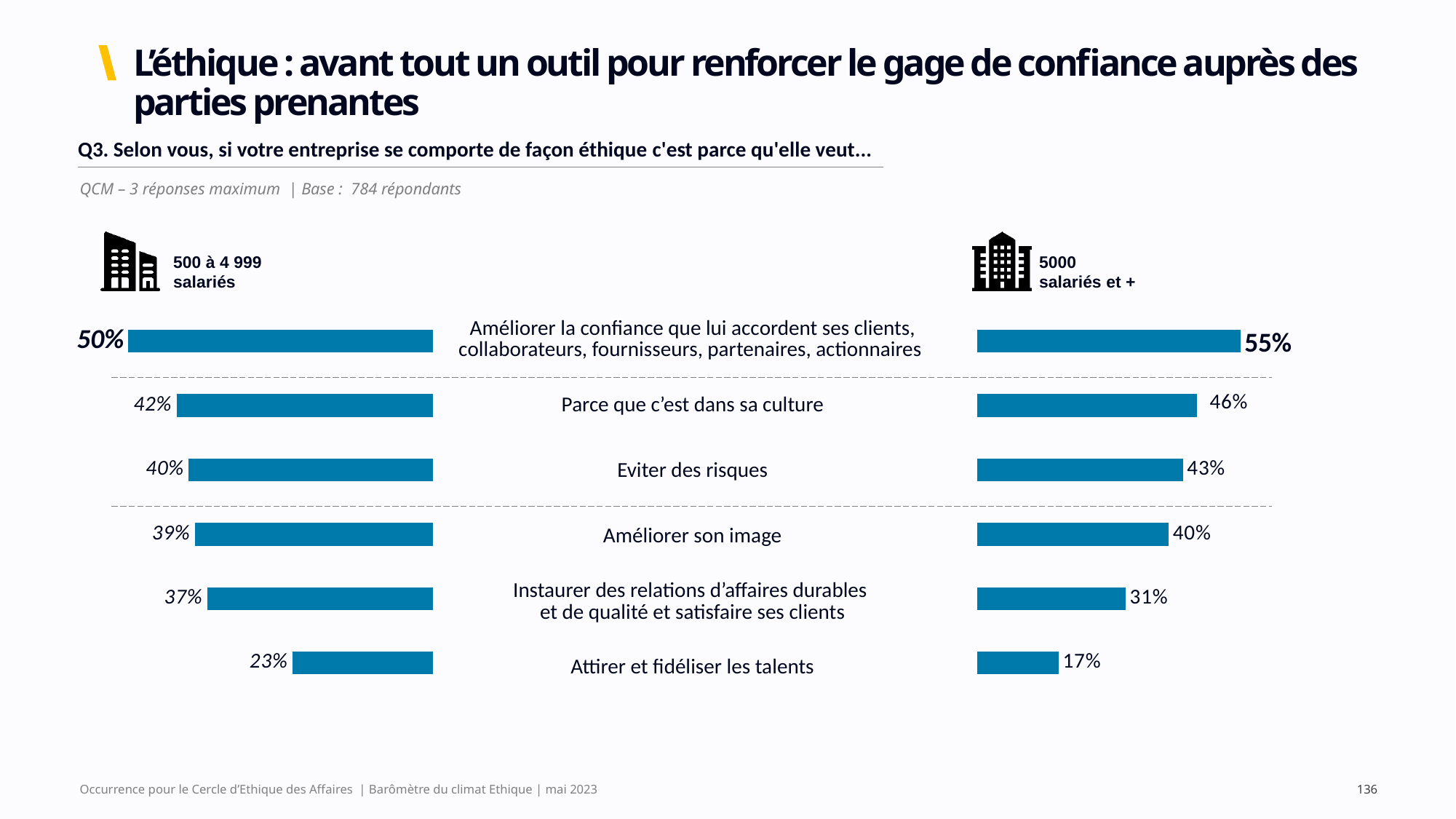
In the left chart (500 à 4 999 salariés), what is the value for "Parce que c'est dans sa culture"? 42% In the right chart (5000 salariés et +), what is the value for "Attirer et fidéliser les talents"? 17% What is the difference between the right chart (5000 salariés et +) and the left chart (500 à 4 999 salariés) for "Améliorer la confiance que lui accordent ses clients, collaborateurs, fournisseurs, partenaires, actionnaires"? 5 percentage points In the left chart (500 à 4 999 salariés), which category has the highest value? Améliorer la confiance que lui accordent ses clients, collaborateurs, fournisseurs, partenaires, actionnaires What is the base (number of respondents) stated for this question? 784 répondants For "Instaurer des relations d'affaires durables et de qualité et satisfaire ses clients", which group has the larger value: 500 à 4 999 salariés or 5000 salariés et +? 500 à 4 999 salariés In the right chart (5000 salariés et +), what is the value for "Améliorer son image"? 40% How many categories are shown in each chart? 6 In the right chart (5000 salariés et +), what is the value for "Eviter des risques"? 43% What kind of chart is used on this slide? Bar chart In the left chart (500 à 4 999 salariés), what is the difference between "Améliorer son image" and "Attirer et fidéliser les talents"? 16 percentage points In the right chart (5000 salariés et +), which category has the lowest value? Attirer et fidéliser les talents